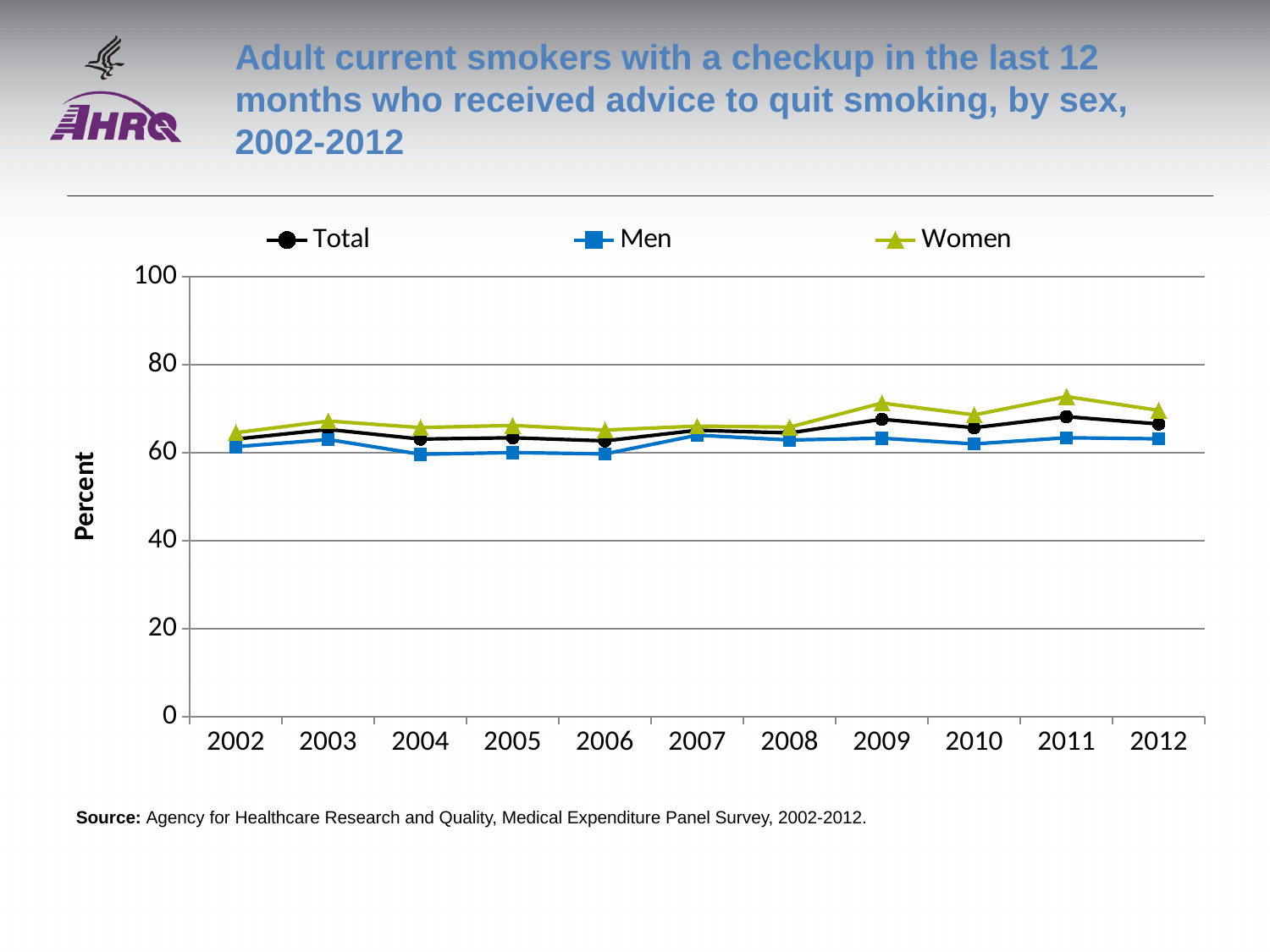
Is the value for Women in 2011 greater or less than 80? less In which year does the Women series reach its highest value? 2011 How many series does the legend list? 3 Is the value for Total in 2009 greater or less than 40? greater Is the value for Women in 2011 greater or less than 60? greater What kind of chart is shown on the slide? Line chart How many years are plotted along the x axis? 11 Which series are listed in the legend? Total, Men, Women Does the Women series rise or fall from 2008 to 2009? Rise In 2011, which is larger, the value for Women or the value for Men? Women What is the label on the vertical axis? Percent